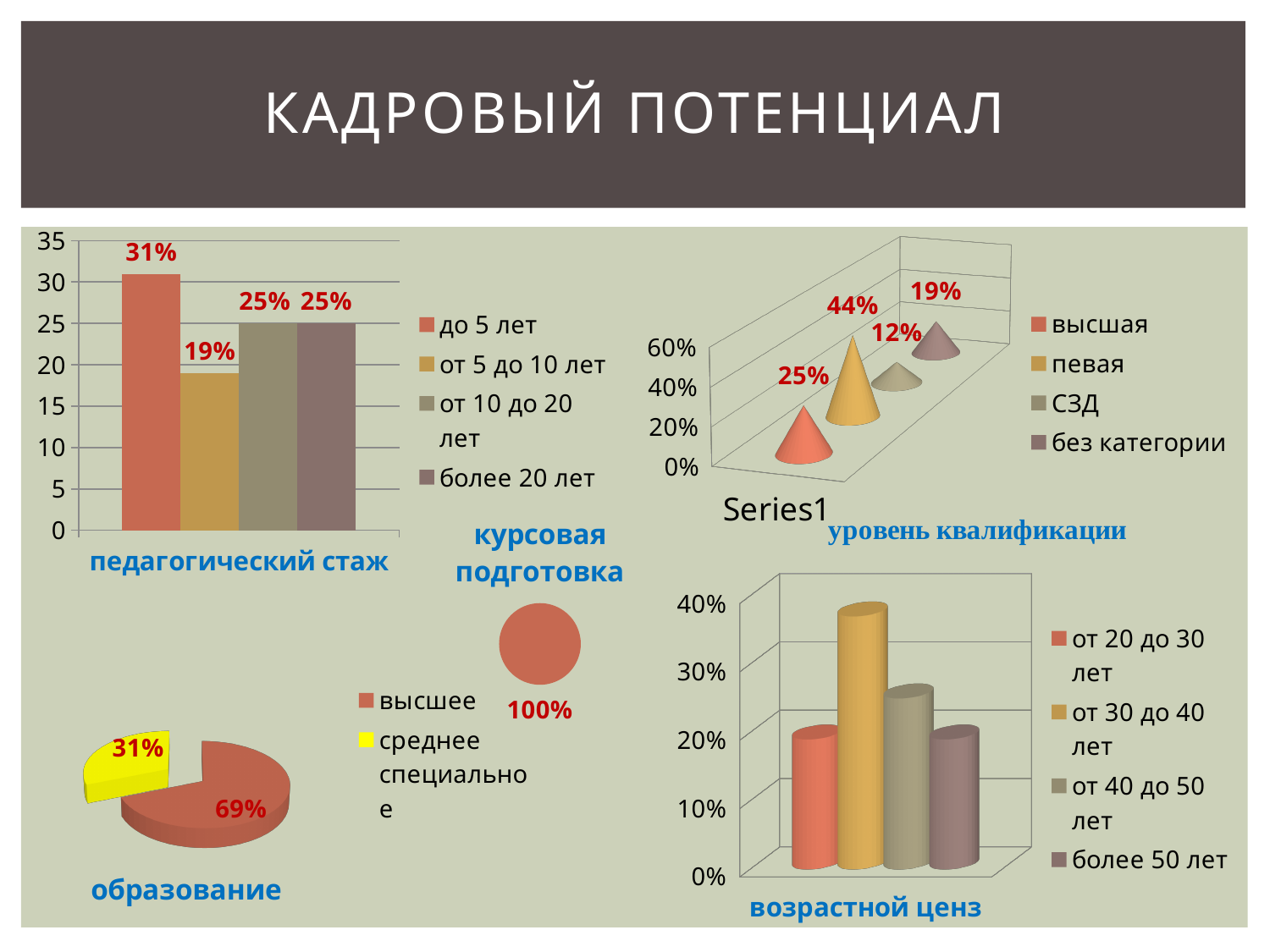
In the 'педагогический стаж' chart, what is the difference between 'до 5 лет' and 'от 5 до 10 лет'? 12% How many categories does the legend of the 'педагогический стаж' chart list? 4 In the 'педагогический стаж' chart, which category has the lowest value? от 5 до 10 лет In the 'образование' pie chart, what colour is the 'среднее специальное' slice? yellow In the 'возрастной ценз' chart, which category has the highest value? от 30 до 40 лет In the 'педагогический стаж' chart, what is the value for 'до 5 лет'? 31% In the 'уровень квалификации' chart, which category has the lowest value? СЗД In the 'уровень квалификации' chart, what is the value for 'певая'? 44% In the 'уровень квалификации' chart, which is larger: 'высшая' or 'без категории'? высшая In the 'уровень квалификации' chart, which category has the highest value? певая In the 'возрастной ценз' chart, is the value for 'от 30 до 40 лет' greater or less than 30%? greater In the 'образование' pie chart, what share does 'высшее' have? 69%